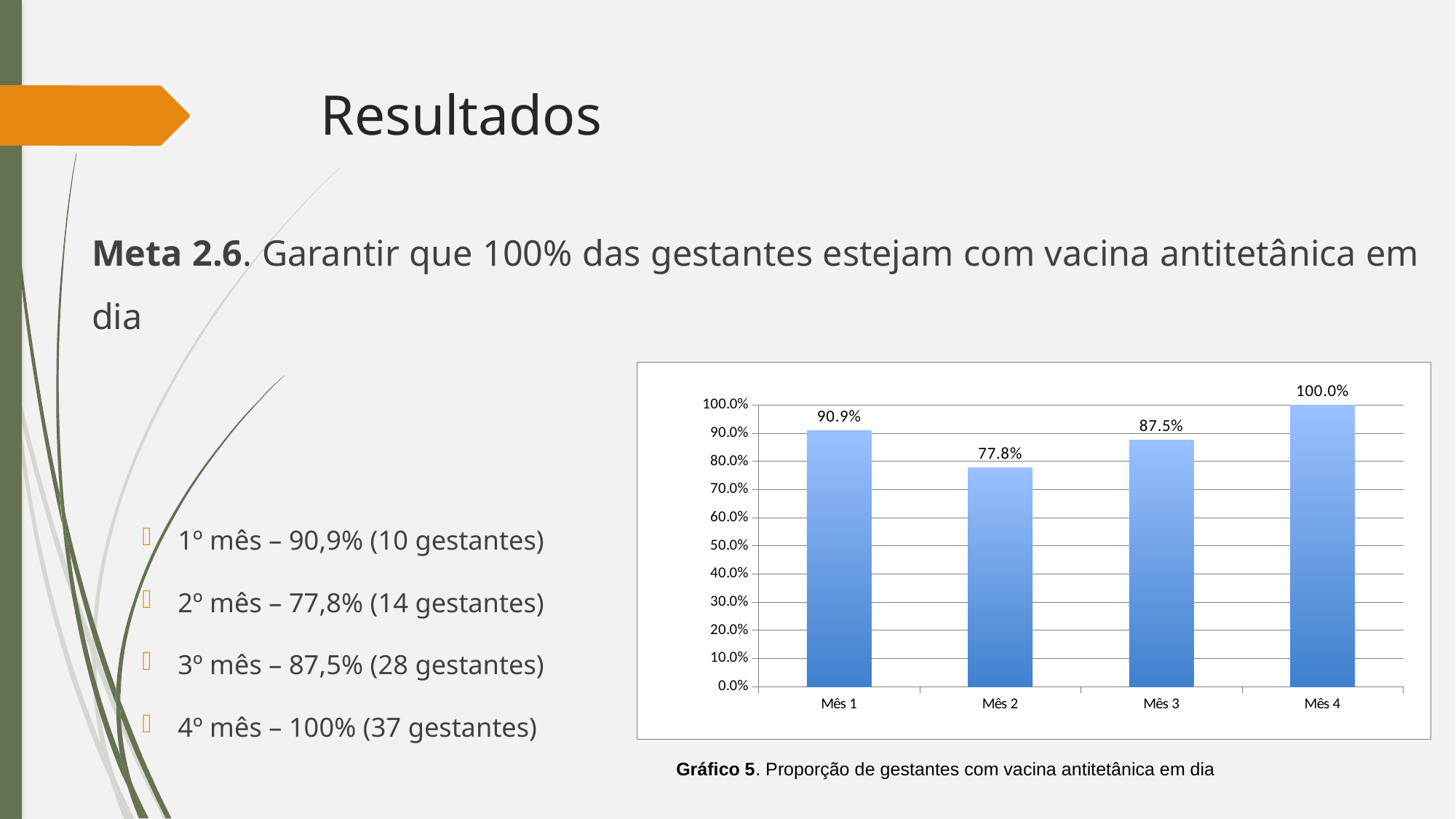
Is the value for Mês 2 greater or less than 80.0%? less What is the value for Mês 1? 90.9% What is the value for Mês 2? 77.8% What kind of chart is shown? bar chart Which month has the highest value? Mês 4 What is the caption of the chart? Gráfico 5. Proporção de gestantes com vacina antitetânica em dia What is the value for Mês 4? 100.0% How many months are shown on the x axis? 4 What is the value for Mês 3? 87.5% Which month has the lowest value? Mês 2 What is the difference between the values for Mês 4 and Mês 2? 22.2% Which is larger, the value for Mês 1 or the value for Mês 3? Mês 1